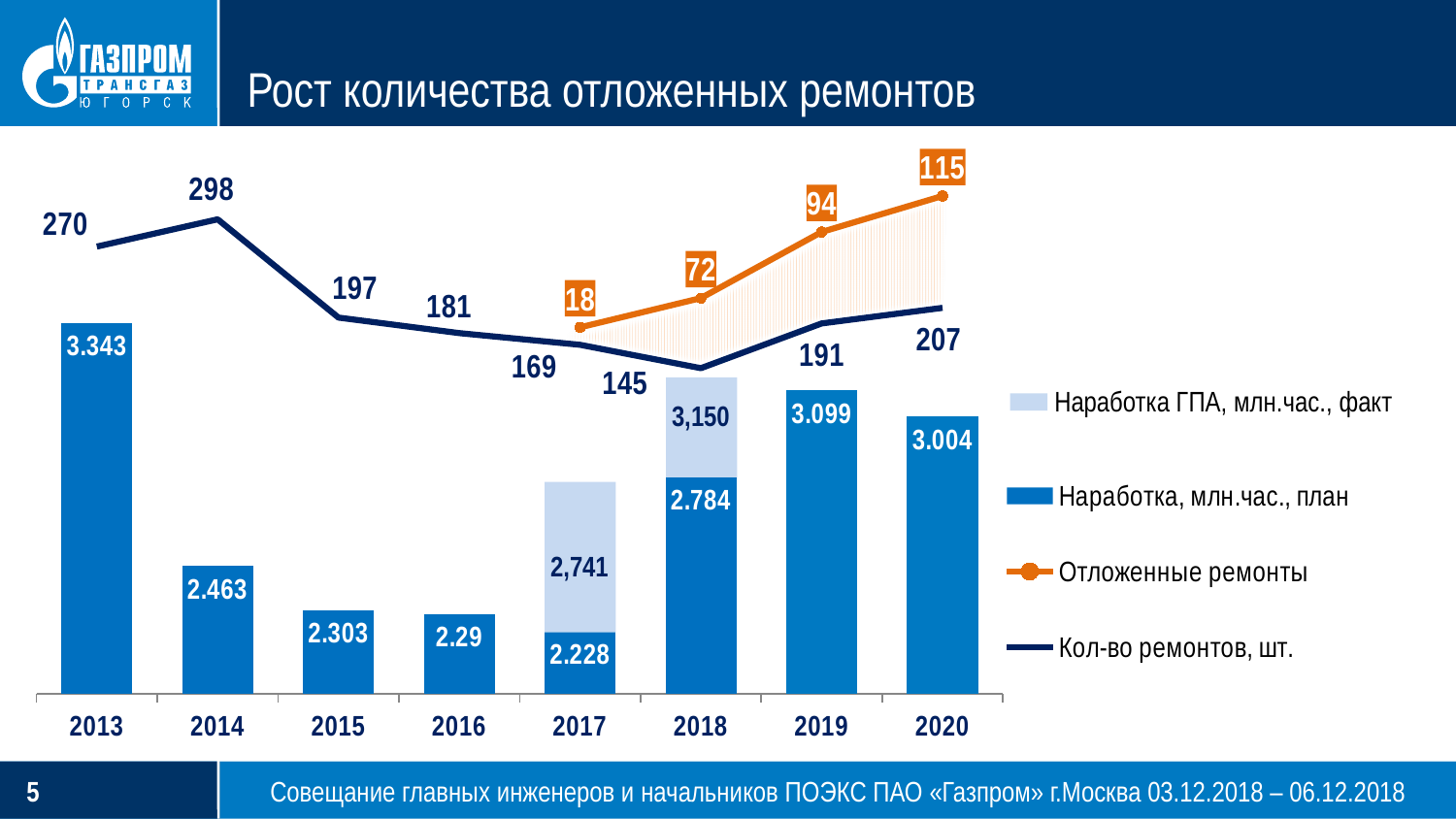
What is the difference between Отложенные ремонты in 2020 and in 2019? 21 Which is larger: the planned operating time for 2019 or for 2020? 2019 How many series does the legend list? 4 In which year is Кол-во ремонтов, шт. highest? 2014 By how much does Кол-во ремонтов, шт. in 2014 exceed the value in 2013? 28 What is the value of Кол-во ремонтов, шт. for 2016? 181 Does Отложенные ремонты rise or fall from 2017 to 2020? rise How many years are shown on the x axis? 8 What is the value of Отложенные ремонты for 2020? 115 What is the planned operating time (Наработка, млн.час., план) for 2013? 3.343 In which year is the planned operating time (Наработка, млн.час., план) lowest? 2017 What is the actual operating time (Наработка ГПА, млн.час., факт) shown for 2018? 3,150